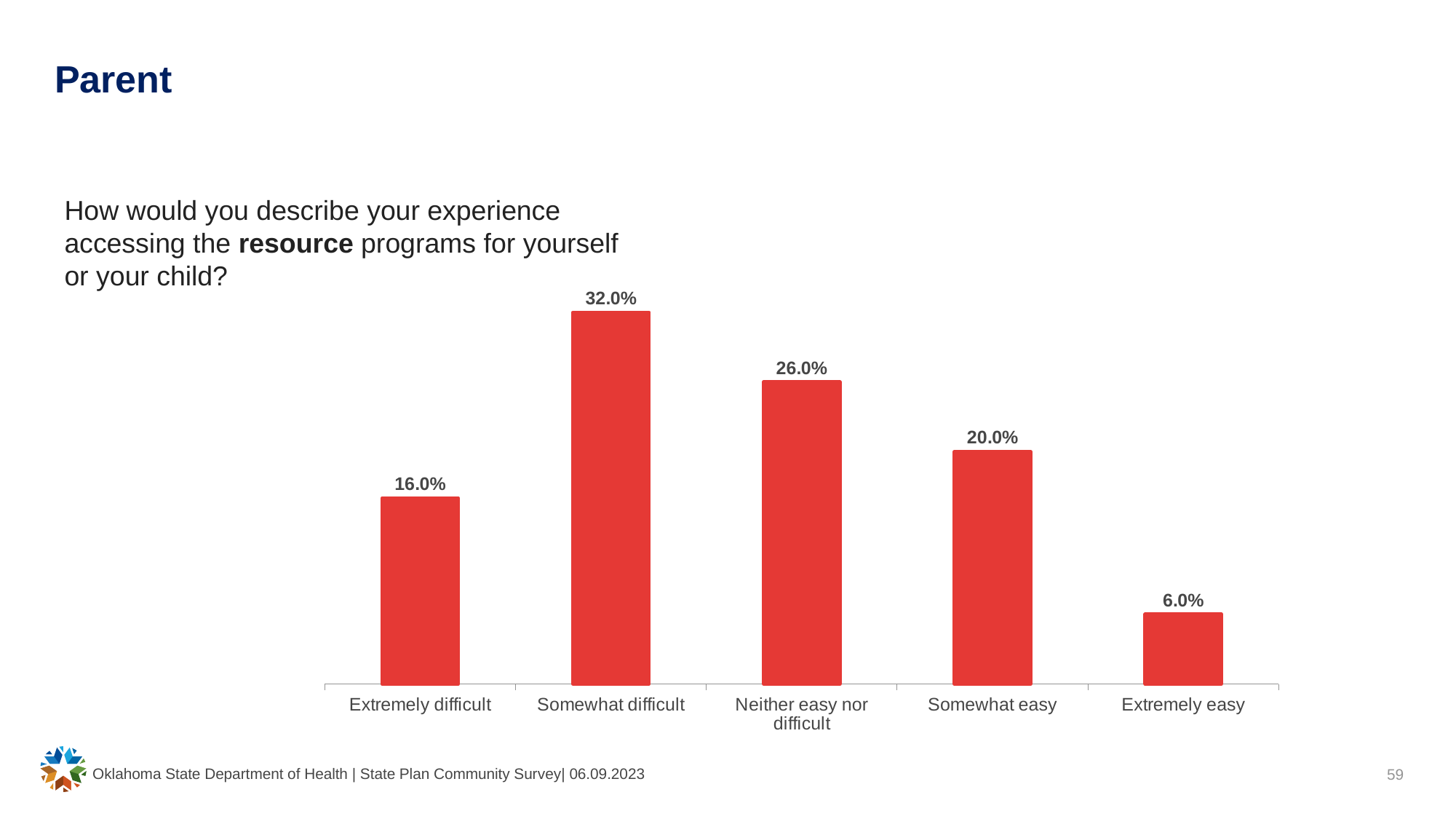
How many categories are shown on the x axis? 5 What is the value shown for Extremely easy? 6.0% Do the values rise or fall from Somewhat difficult to Extremely easy along the x axis? Fall What is the value shown for Neither easy nor difficult? 26.0% What percentage of parents described their experience accessing resource programs as Somewhat difficult? 32.0% What is the difference between the values for Extremely difficult and Extremely easy? 10.0% What is the difference between the values for Somewhat difficult and Somewhat easy? 12.0% What kind of chart is shown on the slide? Bar chart What colour are the bars in the chart? Red Which is larger, the value for Neither easy nor difficult or the value for Somewhat easy? Neither easy nor difficult Which category has the highest value? Somewhat difficult Which category has the lowest value? Extremely easy